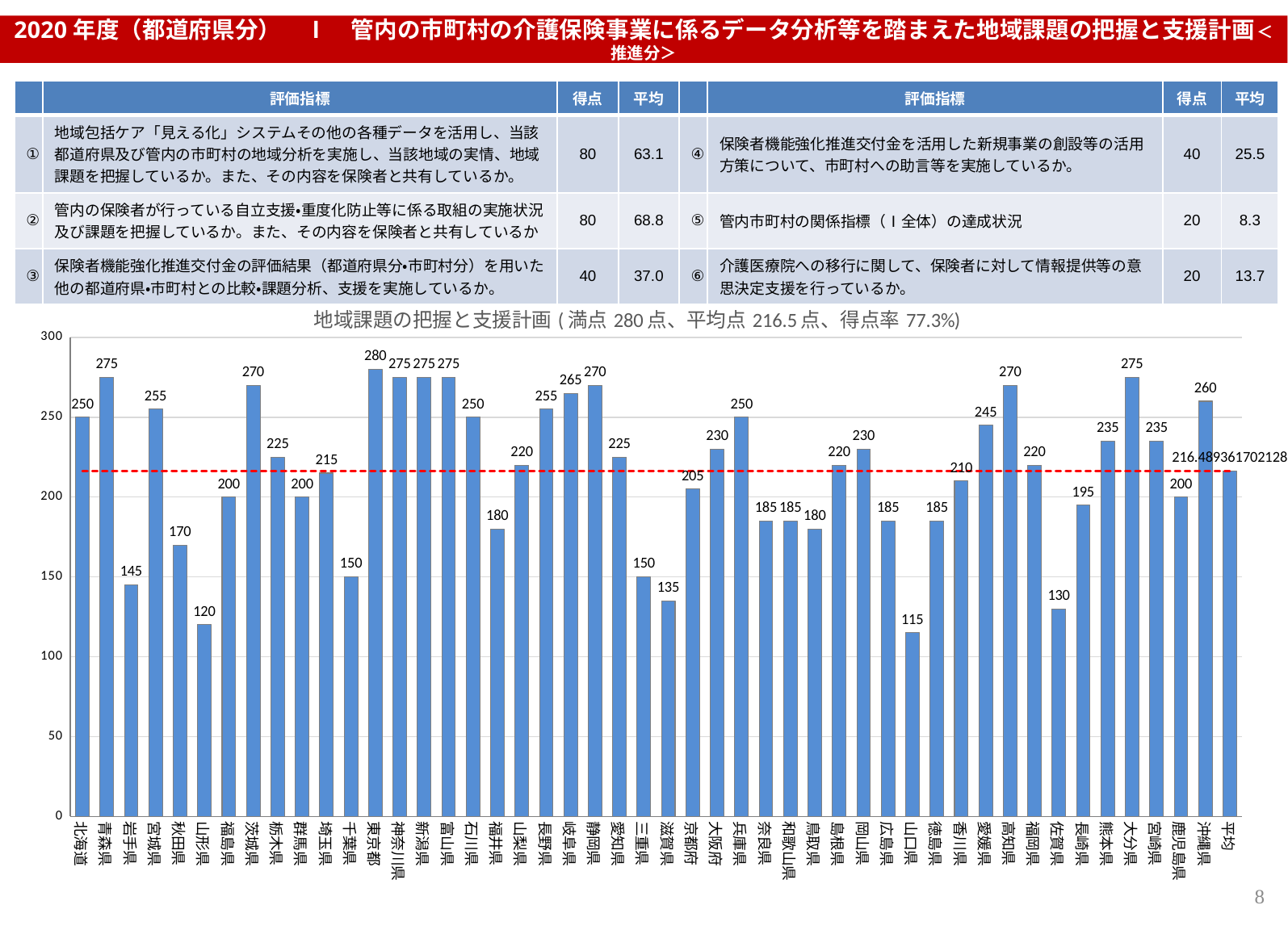
グラフで東京都の値はいくつですか？ 280 グラフのタイトルに示されている得点率はいくつですか？ 77.3% グラフには平均を含めていくつの棒がありますか？ 48 グラフで最も値が低い都道府県はどこですか？ 山口県 グラフで滋賀県の値は150より大きいですか、小さいですか？ 小さい グラフで沖縄県の値はいくつですか？ 260 このグラフの種類は何ですか？ 棒グラフ グラフで山口県の値はいくつですか？ 115 グラフで大阪府と兵庫県では、どちらの値が大きいですか？ 兵庫県 グラフで青森県と岩手県の値の差はいくつですか？ 130 グラフの赤い点線は何を示していますか？ 平均（216.5点） グラフで最も値が高い都道府県はどこですか？ 東京都